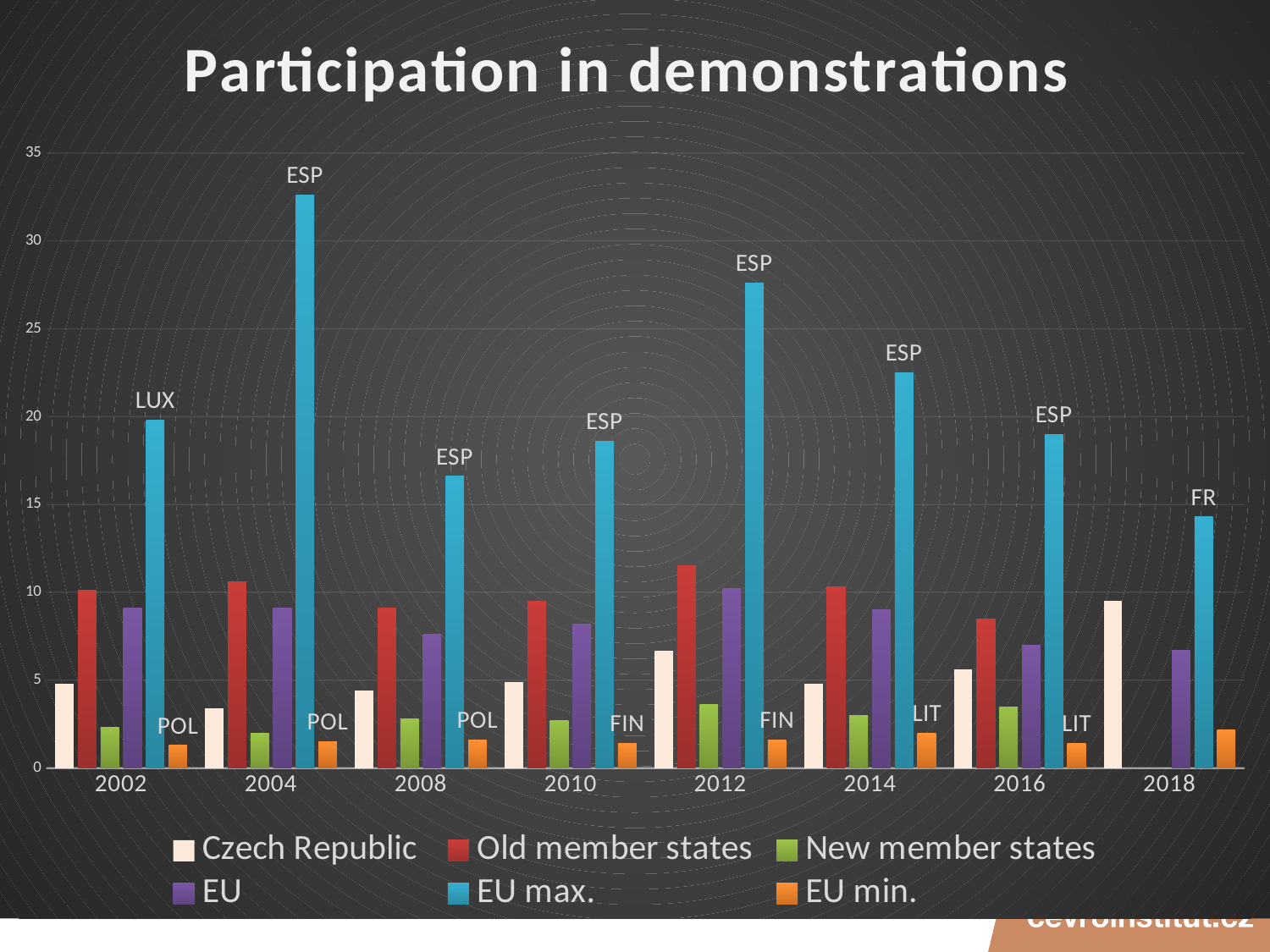
In which year is the Czech Republic bar the highest? 2018 How many series does the legend list? 6 Is the EU max. value for 2004 greater or less than 30? greater Which country label appears above the EU min. bar for 2014? LIT Which is larger, the EU max. value for 2002 or for 2008? 2002 What kind of chart is shown on the slide? bar chart In which year is the EU max. bar the lowest? 2018 Is the EU max. value for 2012 greater or less than 25? greater How many years are shown on the x axis of the chart? 8 Which country label appears above the EU max. bar for 2002? LUX Is the Old member states value for 2012 greater or less than 10? greater In which year is the EU max. bar the highest? 2004